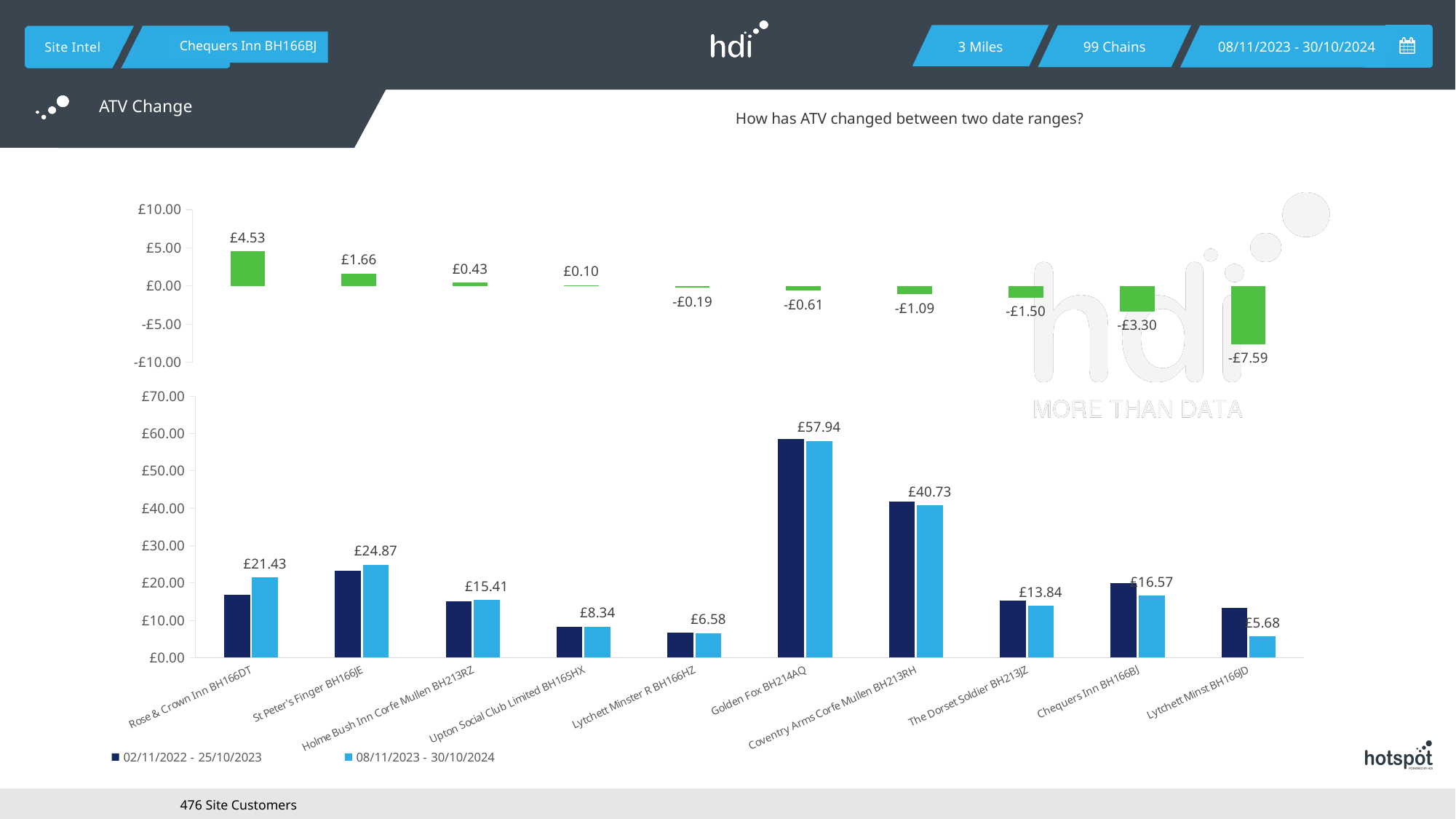
In the bottom chart, what is the value for Golden Fox BH214AQ in the 08/11/2023 - 30/10/2024 series? £57.94 In the bottom chart, is the value for Chequers Inn BH166BJ in the 02/11/2022 - 25/10/2023 series greater or less than £10.00? greater In the top chart, what is the highest value shown? £4.53 In the bottom chart, what is the difference between Golden Fox BH214AQ and Coventry Arms Corfe Mullen BH213RH in the 08/11/2023 - 30/10/2024 series? £17.21 In the bottom chart, which is larger in the 08/11/2023 - 30/10/2024 series: Rose & Crown Inn BH166DT or St Peter's Finger BH166JE? St Peter's Finger BH166JE In the bottom chart, what is the value for Lytchett Minst BH166JD in the 08/11/2023 - 30/10/2024 series? £5.68 In the top chart, what is the lowest value shown? -£7.59 How many categories are shown on the x axis of the bottom chart? 10 How many series does the legend of the bottom chart list? 2 In the bottom chart, which category has the highest value in the 08/11/2023 - 30/10/2024 series? Golden Fox BH214AQ In the bottom chart, which category has the lowest value in the 08/11/2023 - 30/10/2024 series? Lytchett Minst BH166JD What kind of chart is the top chart? bar chart